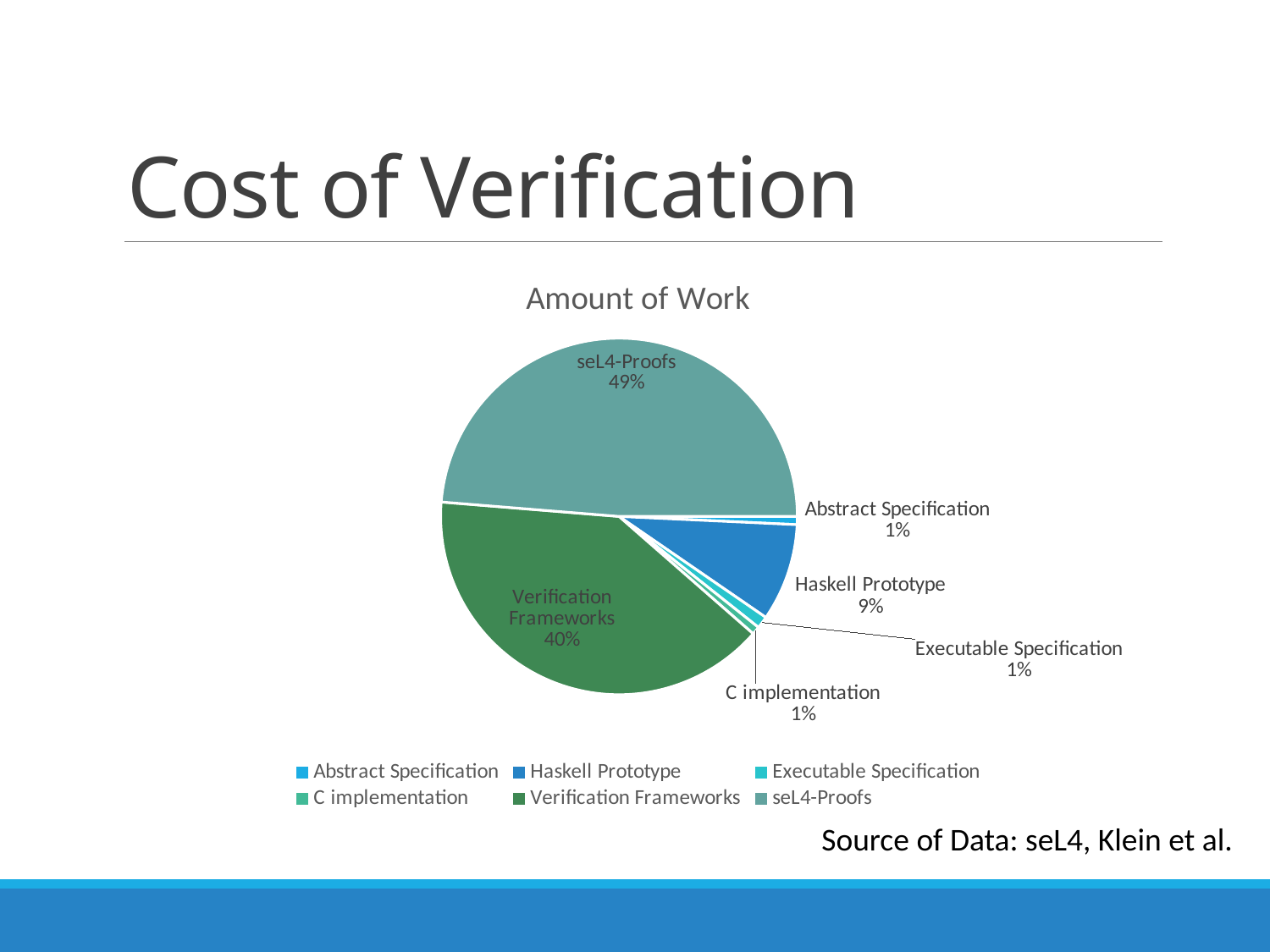
What is the combined share of seL4-Proofs and Verification Frameworks? 89% What share of the pie does Haskell Prototype take? 9% What kind of chart is shown on the slide? pie chart What is the title of the chart? Amount of Work What share of the pie does Abstract Specification take? 1% What share of the pie does Verification Frameworks take? 40% Which is larger, the slice for Haskell Prototype or the slice for Verification Frameworks? Verification Frameworks How many categories does the legend list? 6 What is the difference in percentage points between seL4-Proofs and Verification Frameworks? 9 Which category has the largest slice of the pie? seL4-Proofs